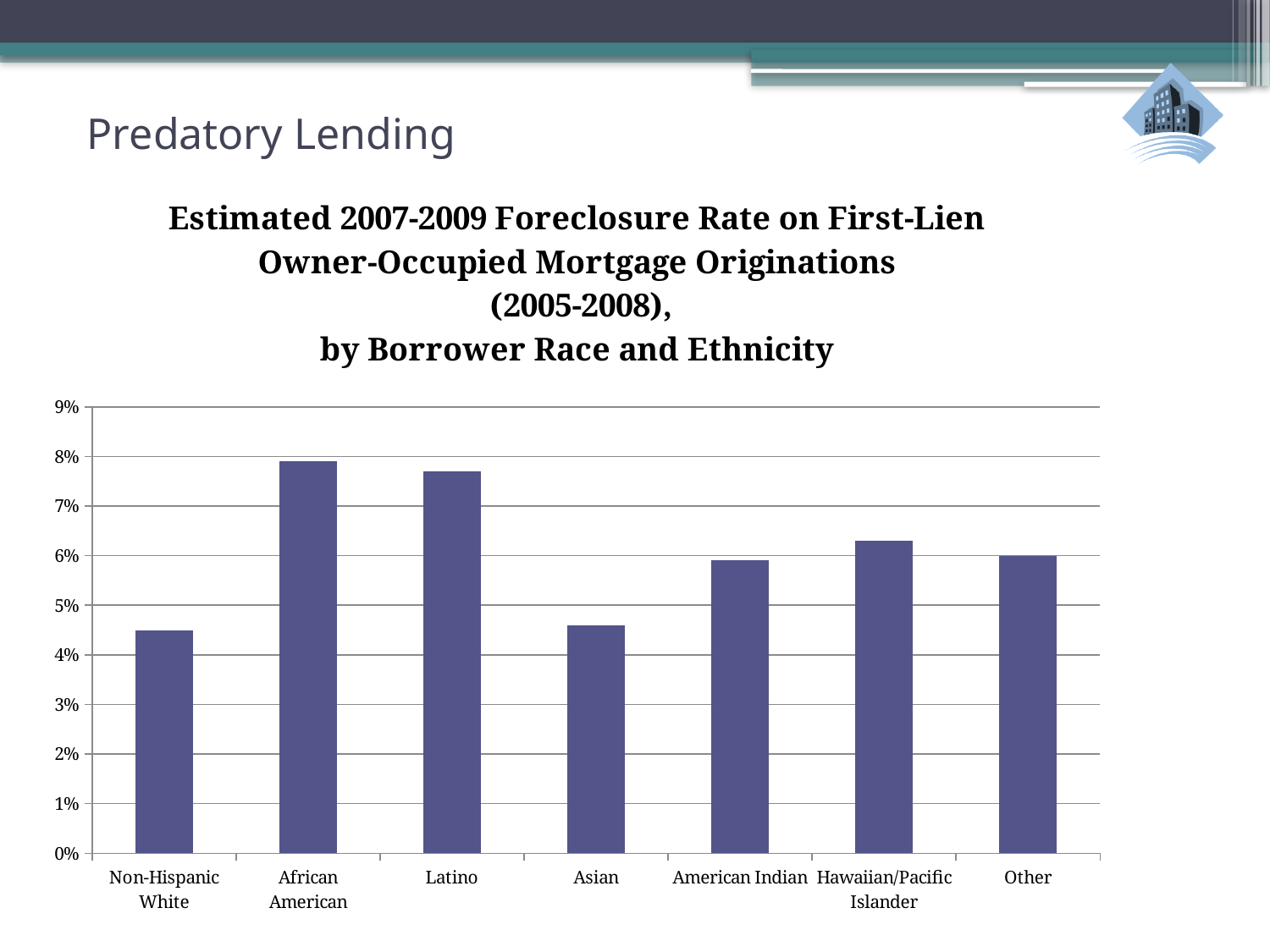
Is the value for Asian greater or less than 5%? less Which has a higher foreclosure rate, African American or Asian? African American Is the value for American Indian greater or less than 5%? greater Is the value for Latino greater or less than 7%? greater What is the highest value shown on the y axis? 9% What kind of chart is shown on the slide? bar chart Which category has the highest estimated foreclosure rate? African American How many borrower race/ethnicity categories are shown on the x axis? 7 Which has a higher foreclosure rate, Hawaiian/Pacific Islander or American Indian? Hawaiian/Pacific Islander